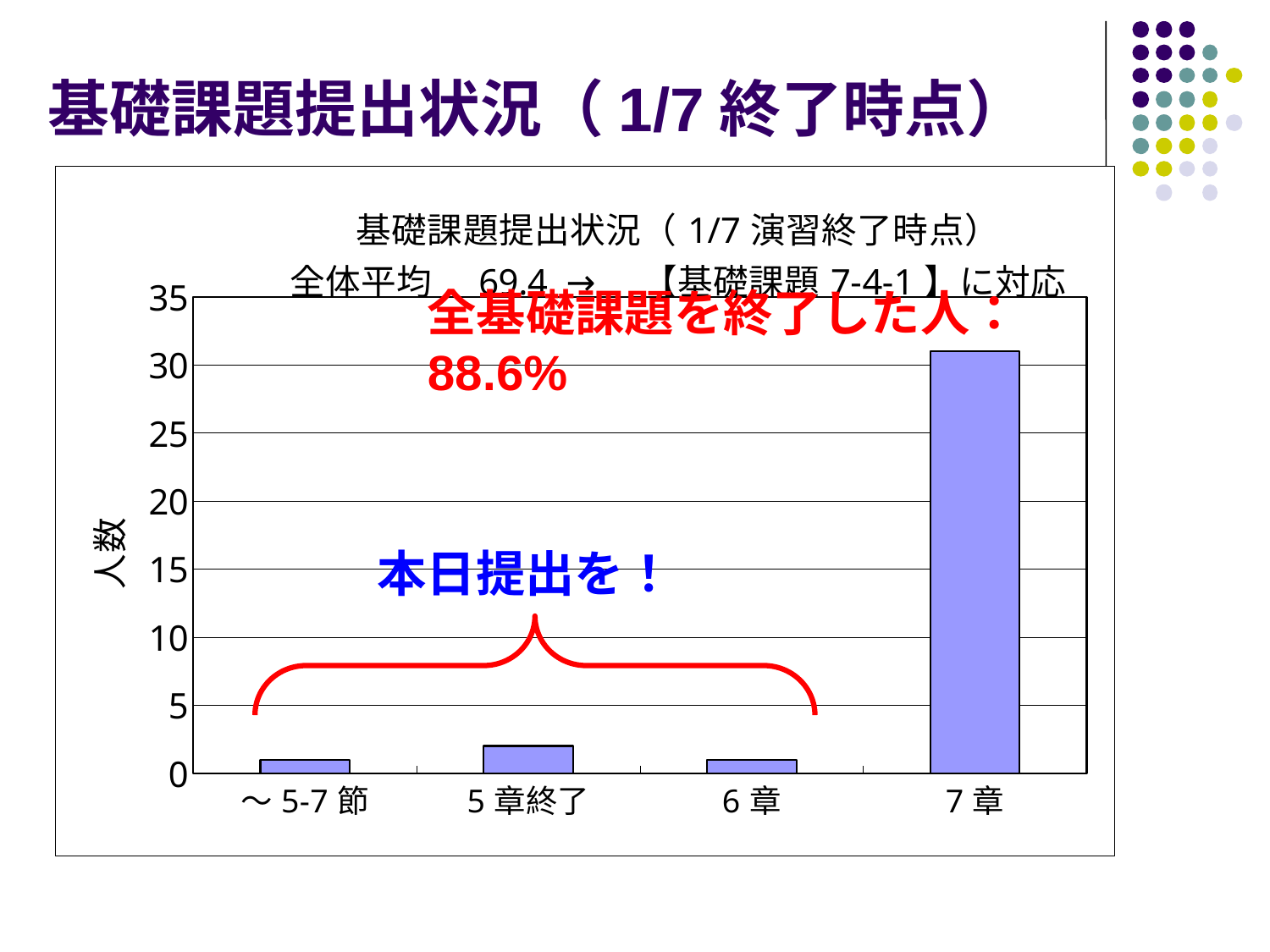
Which is larger, the value for 7章 or the value for 5章終了? 7章 Which is larger, the value for 5章終了 or the value for 6章? 5章終了 Is the value for 5章終了 greater or less than 5? less What is the label on the vertical axis of the chart? 人数 What percentage of people completed all basic assignments, according to the red text on the chart? 88.6% Is the value for 7章 greater or less than 25? greater Is the value for ～5-7節 greater or less than 5? less How many categories are shown on the x axis of the chart? 4 What kind of chart is shown on the slide? bar chart Which category has the highest value in the chart? 7章